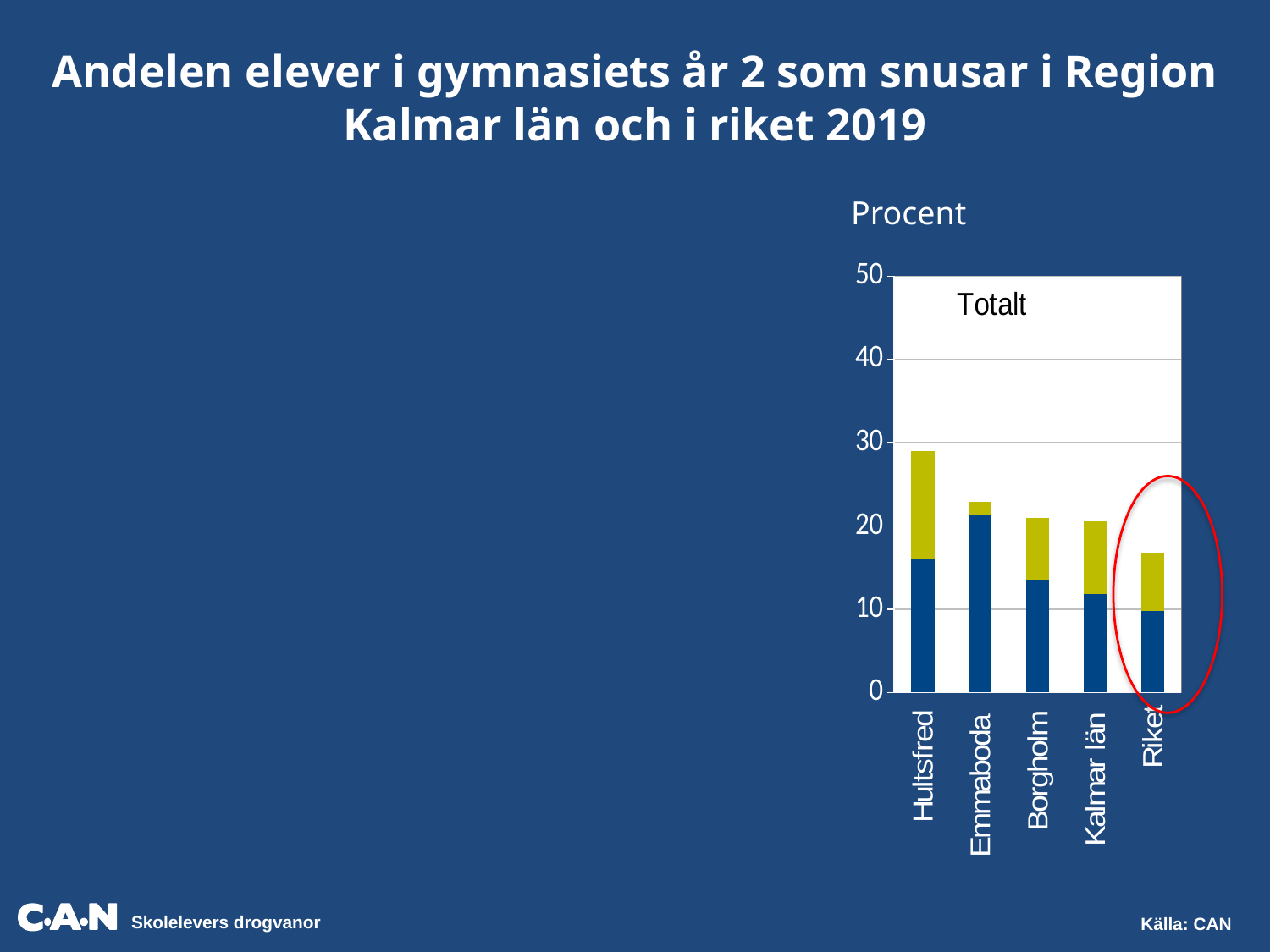
What kind of chart is shown on the slide? Stacked bar chart Which category's bar is circled in red on the chart? Riket Is the total value for Riket greater or less than 20? less Which category has the lowest total bar in the chart? Riket Do the total bar heights rise or fall from left to right along the x axis? Fall Which has the larger total bar, Kalmar län or Riket? Kalmar län Is the total value for Hultsfred greater or less than 20? greater Is the total value for Borgholm greater or less than 30? less Which category has the highest total bar in the chart? Hultsfred Which has the larger total bar, Hultsfred or Emmaboda? Hultsfred How many categories are shown on the x axis of the chart? 5